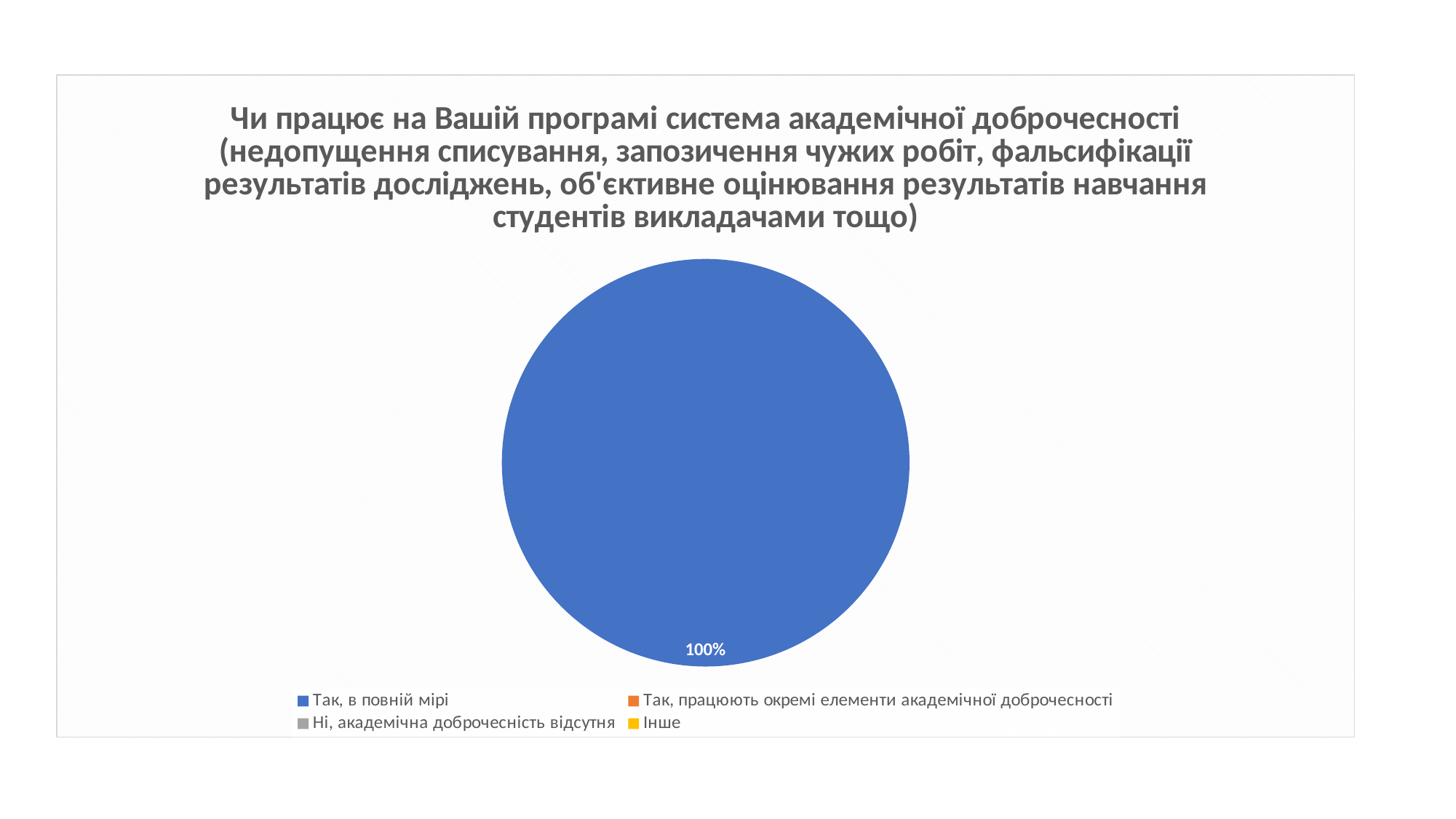
Which legend entry is shown with a yellow marker? Інше Is the share for "Так, в повній мірі" greater or less than 50%? greater What kind of chart is shown on the slide? pie chart Which category accounts for the entire pie? Так, в повній мірі How many data labels are printed on the pie? 1 How many categories does the legend list? 4 What is the share of the pie for "Так, в повній мірі"? 100% What colour is the slice for "Так, в повній мірі"? blue What share of the pie does the slice labelled on the chart represent? 100%